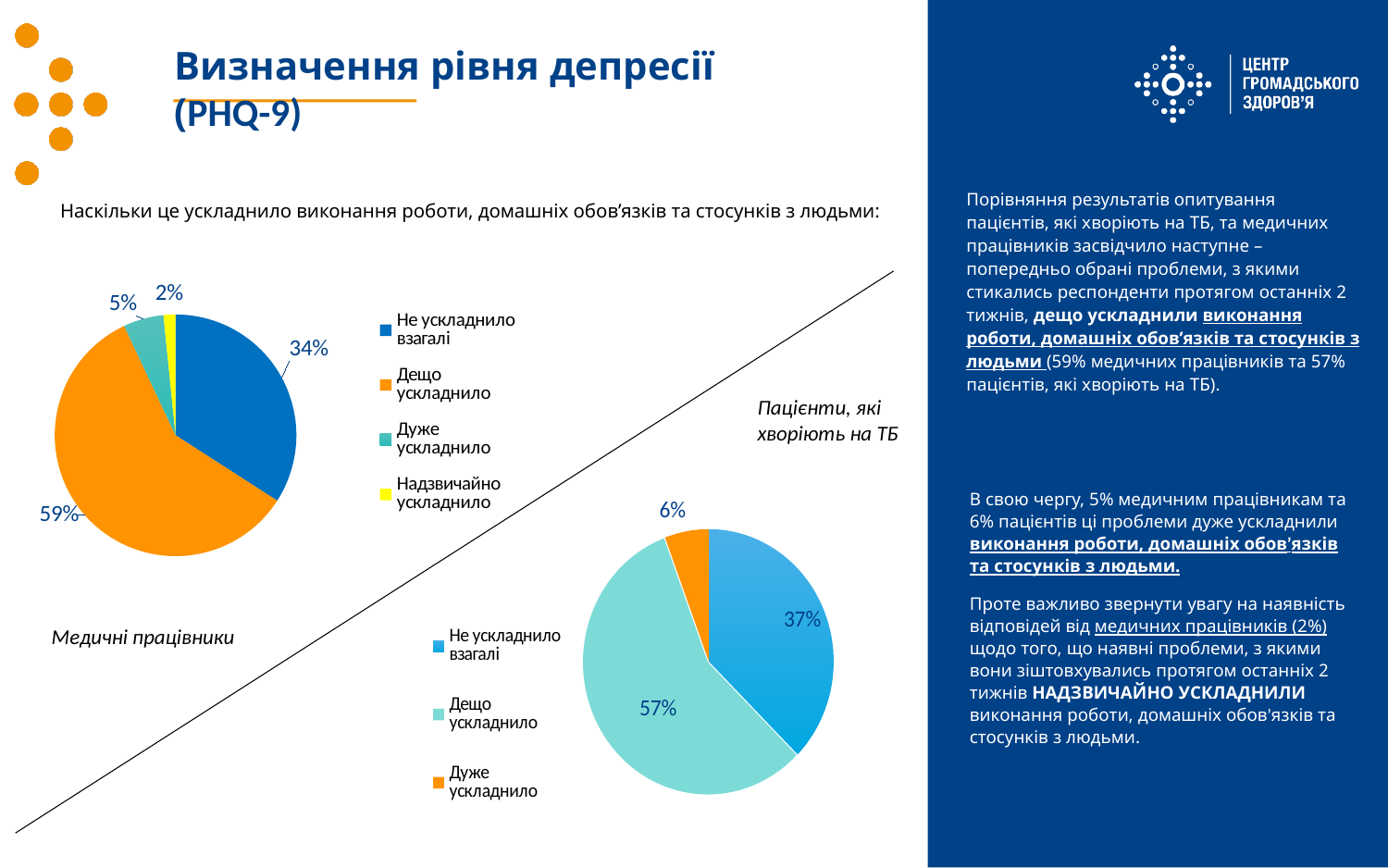
Which is larger: the 'Не ускладнило взагалі' share in the 'Медичні працівники' chart or in the 'Пацієнти, які хворіють на ТБ' chart? Пацієнти, які хворіють на ТБ In the 'Пацієнти, які хворіють на ТБ' pie chart, what share is labelled for 'Не ускладнило взагалі'? 37% What is the difference between the 'Дещо ускладнило' share for medical workers (Медичні працівники) and for TB patients (Пацієнти, які хворіють на ТБ)? 2% How many categories does the legend of the 'Пацієнти, які хворіють на ТБ' pie chart list? 3 In the 'Медичні працівники' pie chart, which category has the smallest slice? Надзвичайно ускладнило In the 'Медичні працівники' pie chart, what share is labelled for 'Надзвичайно ускладнило'? 2% In the 'Медичні працівники' pie chart, which category has the largest slice? Дещо ускладнило In the 'Медичні працівники' pie chart, what share is labelled for 'Дещо ускладнило'? 59% In the 'Пацієнти, які хворіють на ТБ' pie chart, which category has the smallest slice? Дуже ускладнило How many categories does the legend of the 'Медичні працівники' pie chart list? 4 In the 'Пацієнти, які хворіють на ТБ' pie chart, what share is labelled for 'Дуже ускладнило'? 6% What type of chart is used for the 'Медичні працівники' data? Pie chart